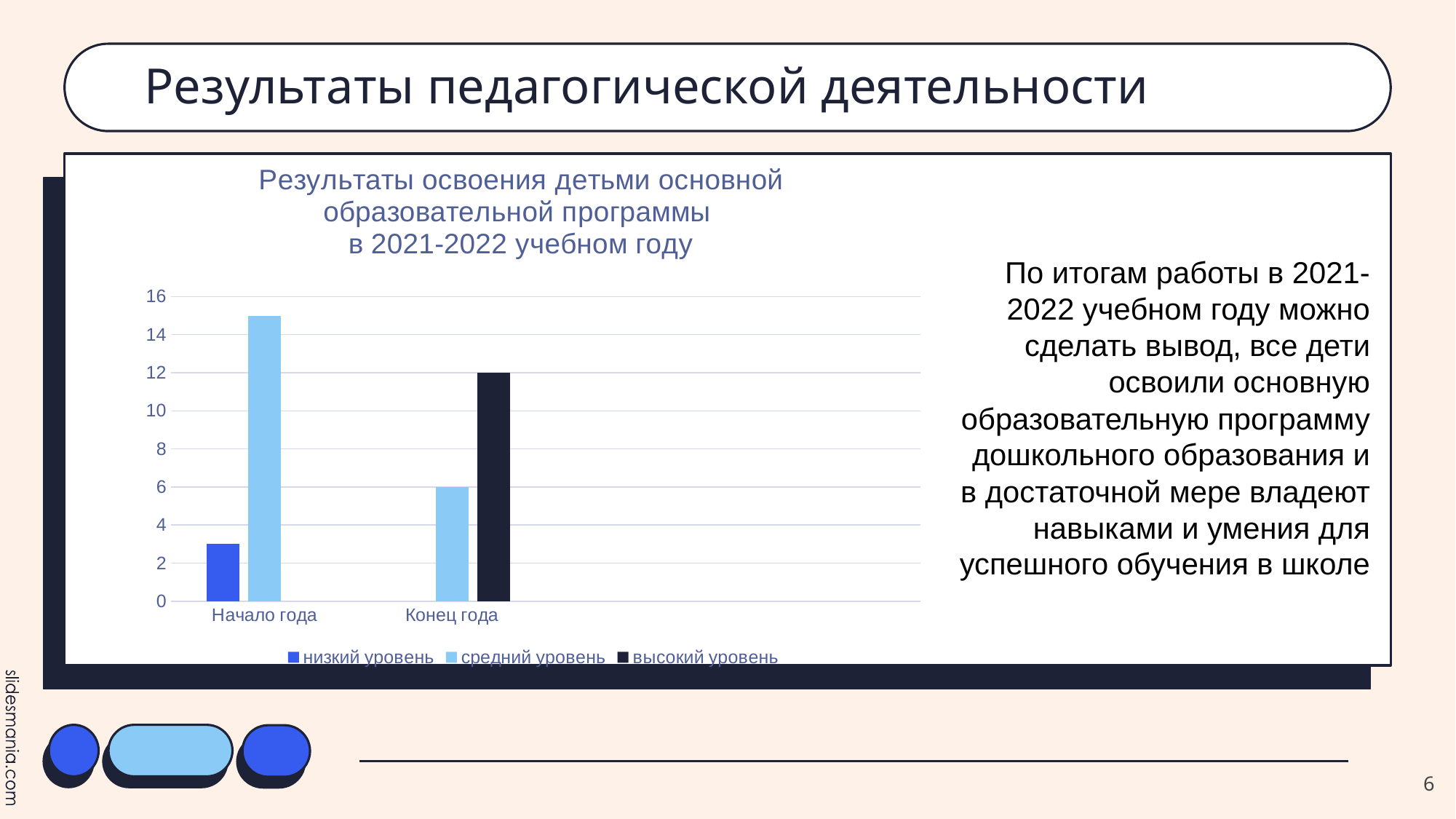
Which series has the tallest bar at Конец года? высокий уровень Which is larger: средний уровень at Начало года or высокий уровень at Конец года? средний уровень at Начало года What is the value for высокий уровень at Конец года? 12 How many series does the chart legend list? 3 Is the value for низкий уровень at Начало года greater or less than 4? less What is the difference between высокий уровень and средний уровень at Конец года? 6 How many categories are shown on the x axis of the chart? 2 What kind of chart is shown on the slide? bar chart What is the value for средний уровень at Конец года? 6 Which series has the tallest bar at Начало года? средний уровень Does the value for средний уровень rise or fall from Начало года to Конец года? fall Is the value for средний уровень at Начало года greater or less than 14? greater